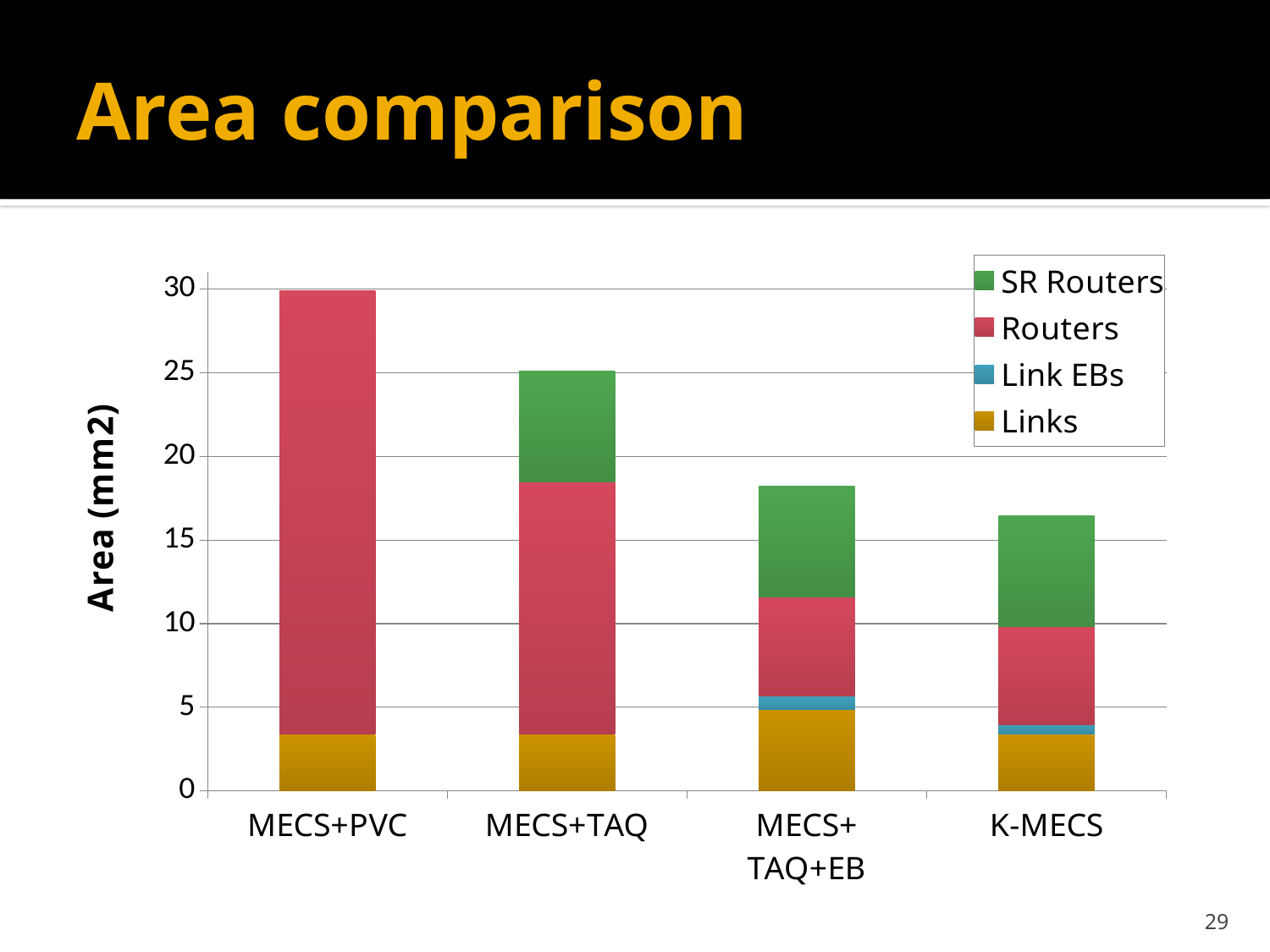
How many series does the legend list? 4 Which category has the tallest stacked bar? MECS+PVC Which category has the shortest stacked bar? K-MECS How many categories are shown on the x axis? 4 Do the total bar heights rise or fall from left to right along the x axis? fall Is the total bar height for K-MECS greater or less than 15? greater What kind of chart is shown on the slide? Stacked bar chart Is the total bar height for MECS+PVC greater or less than 25? greater Which has the larger total area, MECS+TAQ or K-MECS? MECS+TAQ What is the title of the y axis? Area (mm2) Which series is shown in green in the legend? SR Routers Is the total bar height for MECS+TAQ+EB greater or less than 20? less